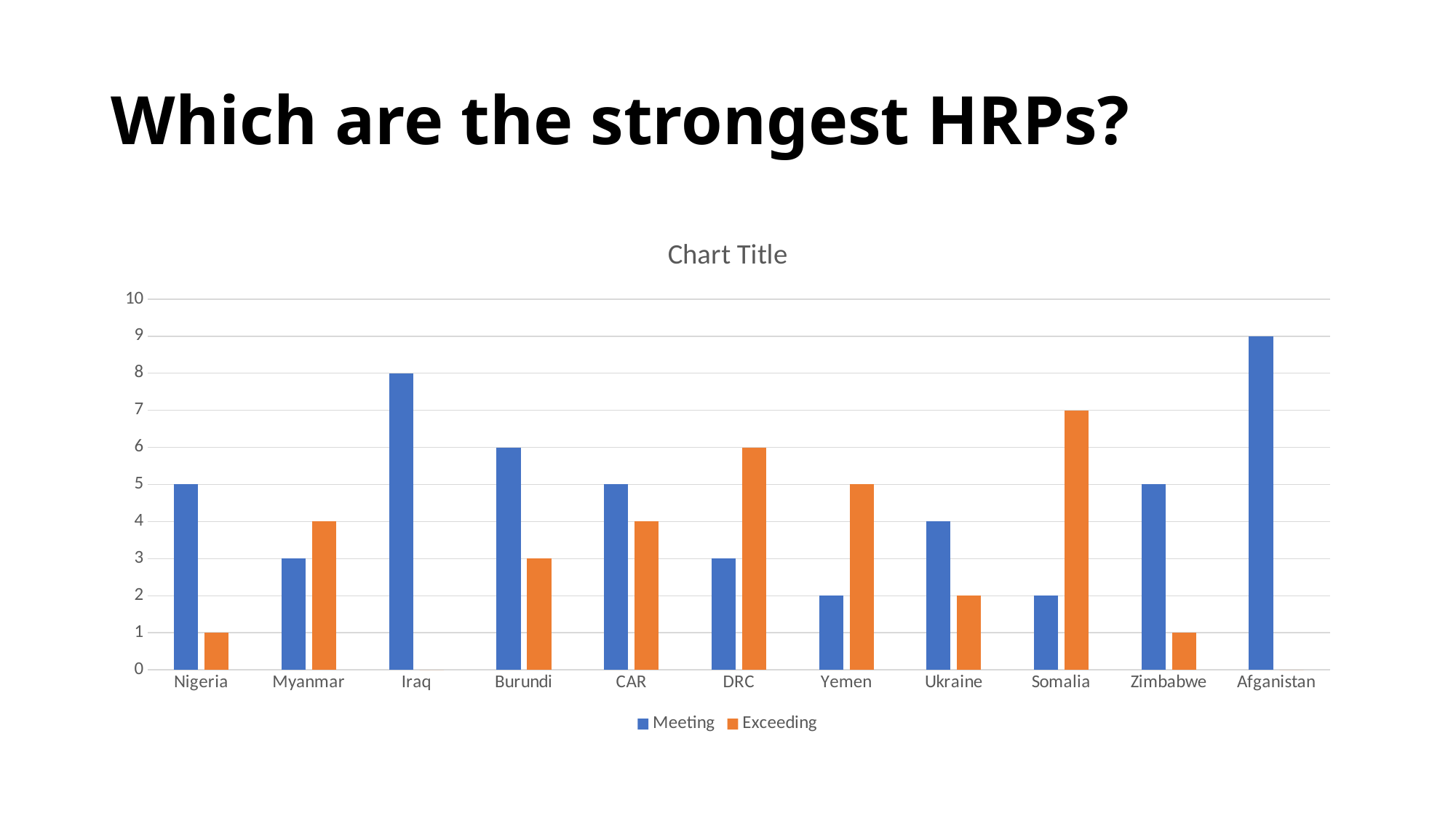
Which category has the highest Meeting value? Afganistan How many categories are shown on the x axis? 11 How many series does the legend list? 2 What kind of chart is shown on the slide? Bar chart What is the difference between the Meeting and Exceeding values for DRC? 3 What is the Meeting value for Afganistan? 9 What is the Meeting value for Iraq? 8 Is the Meeting value for Burundi greater or less than 5? greater What colour represents the Exceeding series? Orange Which category has the highest Exceeding value? Somalia What is the Exceeding value for Somalia? 7 Which is larger for Yemen, the Meeting value or the Exceeding value? Exceeding